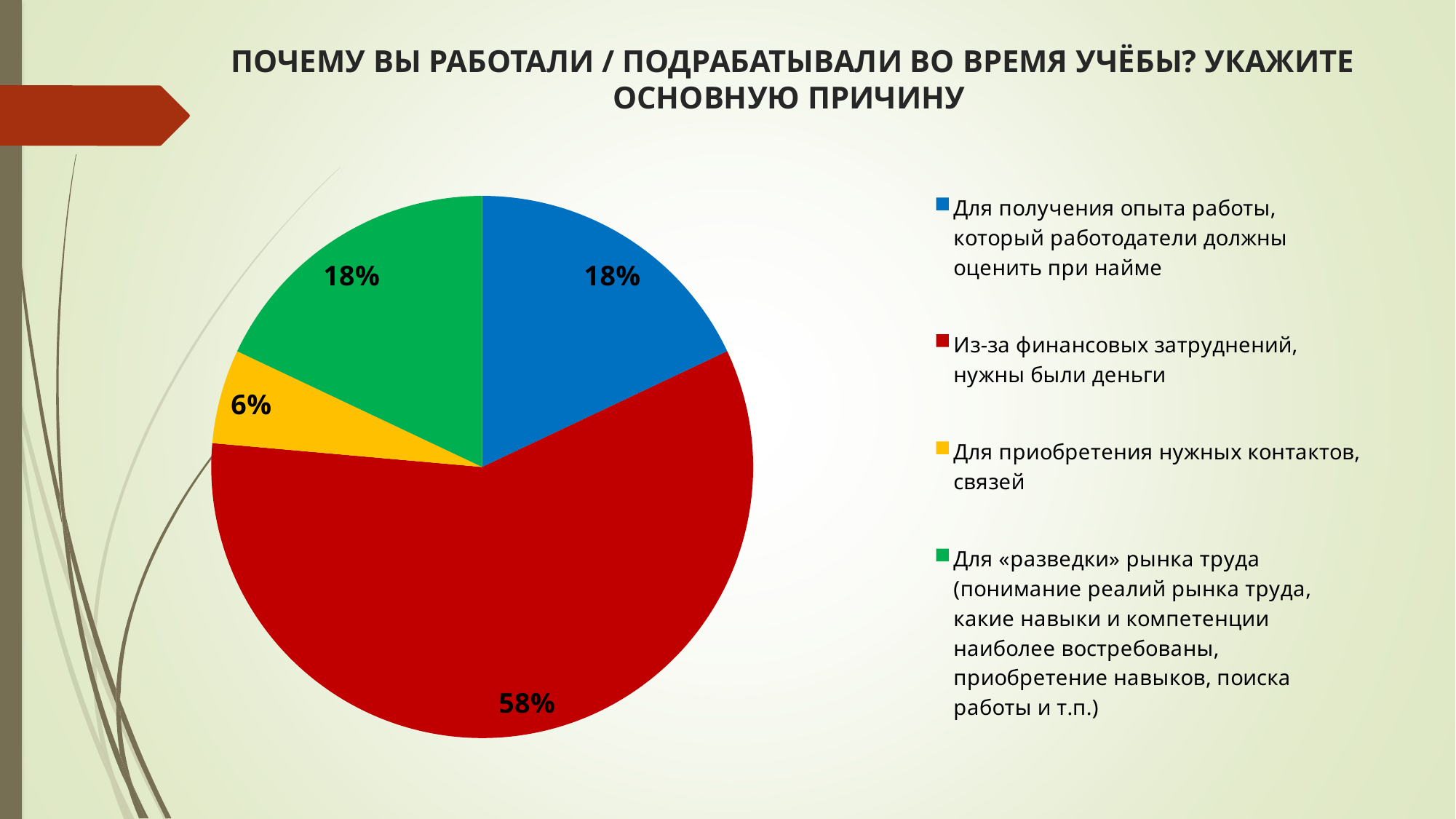
What colour is the slice for "Из-за финансовых затруднений, нужны были деньги"? Red What type of chart is shown on the slide? Pie chart What share of respondents chose "Для «разведки» рынка труда"? 18% Which reason has the smallest share of the pie? Для приобретения нужных контактов, связей What is the title of the chart? ПОЧЕМУ ВЫ РАБОТАЛИ / ПОДРАБАТЫВАЛИ ВО ВРЕМЯ УЧЁБЫ? УКАЖИТЕ ОСНОВНУЮ ПРИЧИНУ What share of respondents chose "Для получения опыта работы, который работодатели должны оценить при найме"? 18% How many slices does the pie chart have? 4 What share of respondents chose "Для приобретения нужных контактов, связей"? 6% Which reason has the largest share of the pie? Из-за финансовых затруднений, нужны были деньги Which is larger: the share for "Для получения опыта работы" or the share for "Для приобретения нужных контактов, связей"? Для получения опыта работы What share of respondents chose "Из-за финансовых затруднений, нужны были деньги"? 58% What is the difference in percentage points between "Из-за финансовых затруднений, нужны были деньги" and "Для приобретения нужных контактов, связей"? 52 percentage points